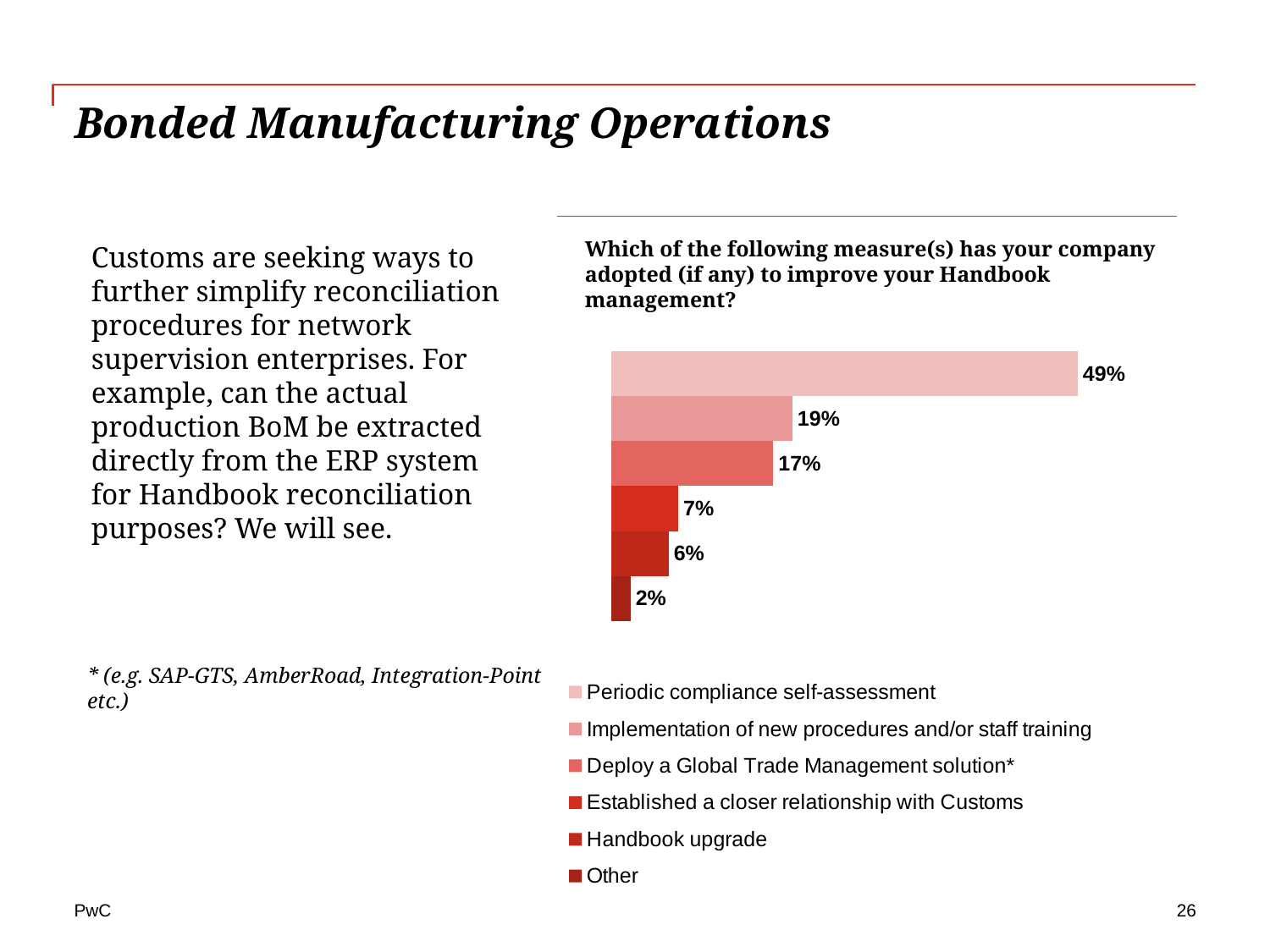
What percentage of companies adopted periodic compliance self-assessment? 49% Which is larger: the value for 'Deploy a Global Trade Management solution' or 'Established a closer relationship with Customs'? Deploy a Global Trade Management solution What is the title of the chart? Which of the following measure(s) has your company adopted (if any) to improve your Handbook management? Which measure has the lowest percentage? Other Which measure has the highest percentage? Periodic compliance self-assessment What percentage is shown for 'Deploy a Global Trade Management solution'? 17% What is the value for 'Handbook upgrade'? 6% What is the difference between 'Established a closer relationship with Customs' and 'Handbook upgrade'? 1% How many measures are plotted in the chart? 6 What is the difference between the percentages for 'Periodic compliance self-assessment' and 'Implementation of new procedures and/or staff training'? 30% What kind of chart is shown on the slide? Bar chart What is the value for 'Implementation of new procedures and/or staff training'? 19%